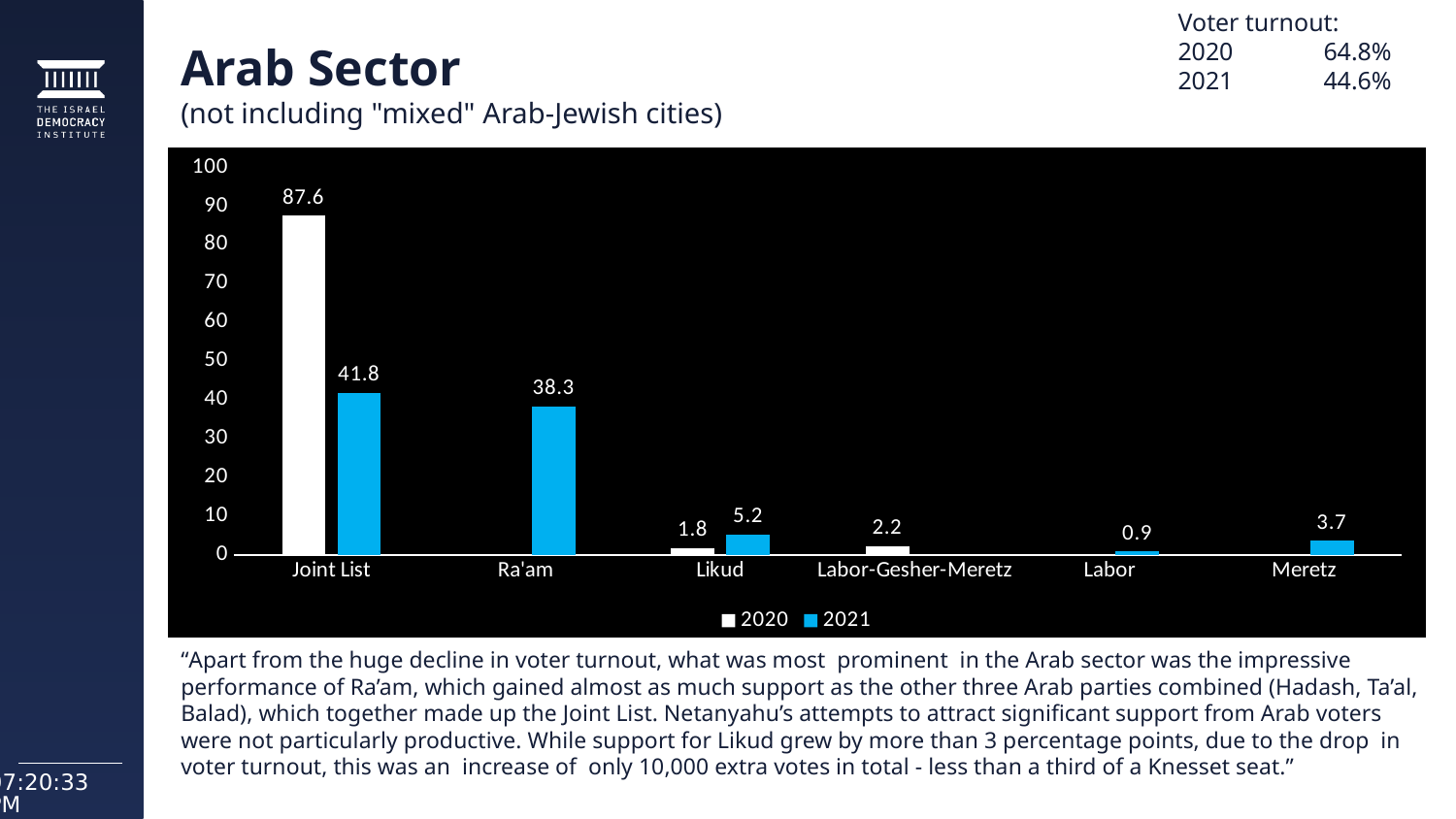
What is the 2020 value for Joint List? 87.6 Which category has the highest 2021 value? Joint List What kind of chart is shown on the slide? Bar chart What is the 2021 value for Ra'am? 38.3 What is the difference between the 2020 and 2021 values for Joint List? 45.8 How many categories are shown on the x axis? 6 What is the 2021 value for Likud? 5.2 What is the 2020 value for Labor-Gesher-Meretz? 2.2 Which category has the lowest 2021 value? Labor Which is larger: the 2021 value for Likud or the 2021 value for Meretz? Likud What is the 2021 value for Joint List? 41.8 How many series does the legend list? 2